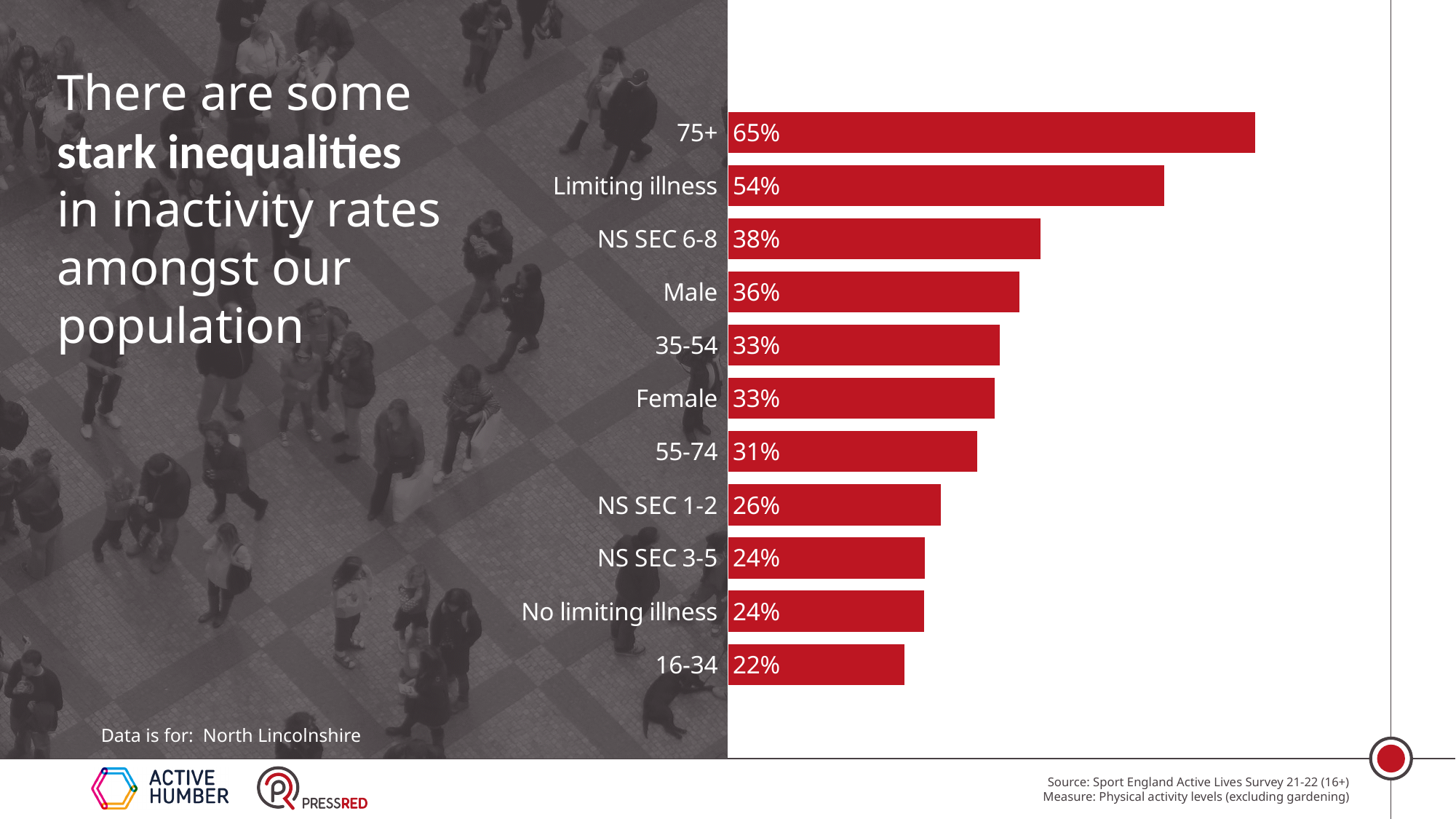
Which has a higher inactivity rate, Male or Female? Male How many categories are shown in the chart? 11 Which category has the highest inactivity rate? 75+ What is the difference in inactivity rate between the 75+ group and the 16-34 group? 43 percentage points What type of chart is shown on the slide? Bar chart What is the inactivity rate for the 16-34 age group? 22% What is the inactivity rate for the 75+ group? 65% Which area is the data on the slide for? North Lincolnshire What is the difference in inactivity rate between Limiting illness and No limiting illness? 30 percentage points What is the inactivity rate for people with a limiting illness? 54% Which category has the lowest inactivity rate? 16-34 What is the inactivity rate for NS SEC 6-8? 38%